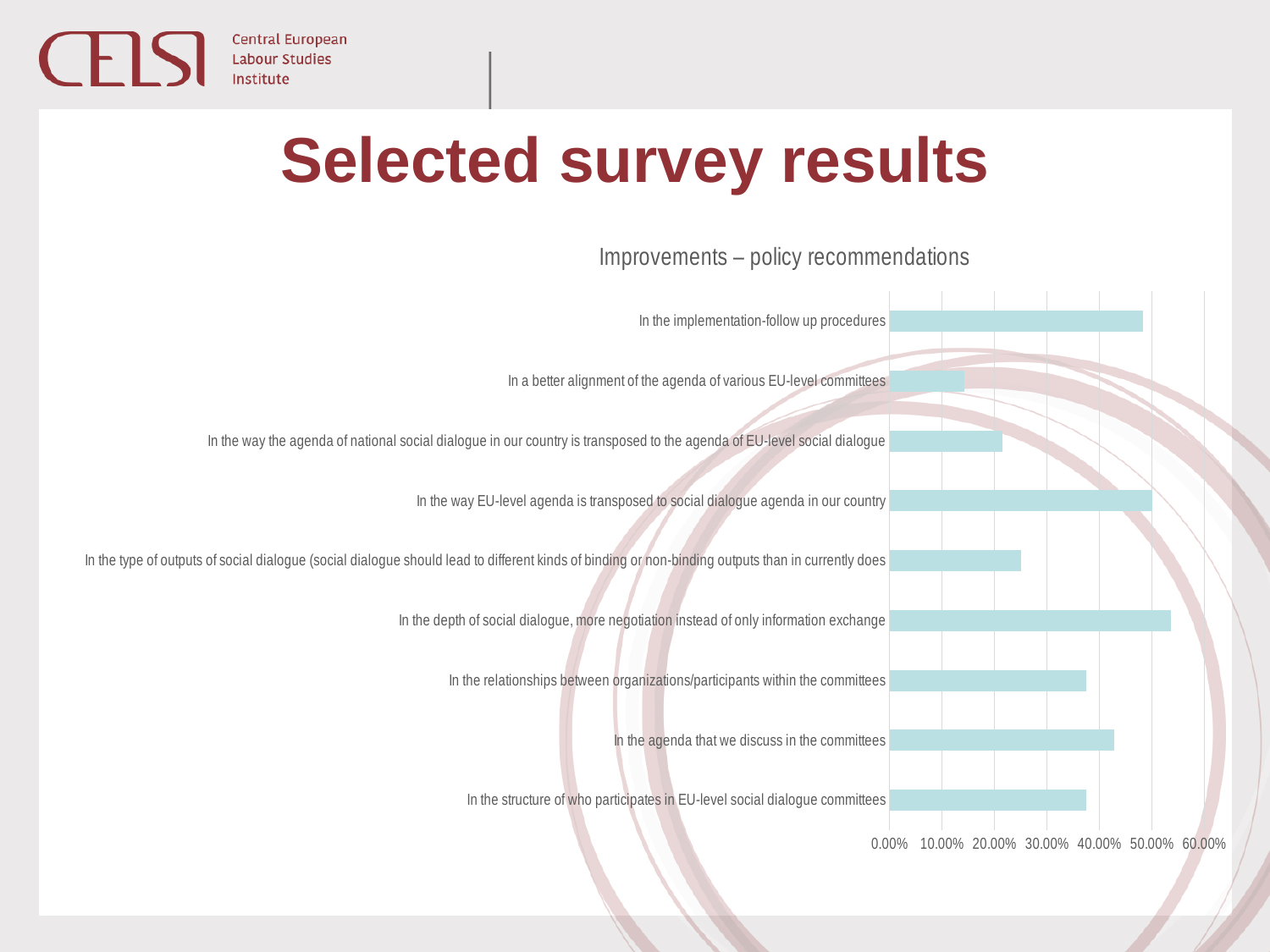
Which category has the highest value? In the depth of social dialogue, more negotiation instead of only information exchange Which category has the lowest value? In a better alignment of the agenda of various EU-level committees Is the value for "In the type of outputs of social dialogue" greater or less than 30.00%? less What kind of chart is shown on the slide? Bar chart Is the value for "In the depth of social dialogue, more negotiation instead of only information exchange" greater or less than 50.00%? greater Which is larger: the value for "In the agenda that we discuss in the committees" or for "In the relationships between organizations/participants within the committees"? In the agenda that we discuss in the committees What is the title of the chart? Improvements – policy recommendations How many categories are plotted in the chart? 9 Is the value for "In a better alignment of the agenda of various EU-level committees" greater or less than 20.00%? less Which is larger: the value for "In the implementation-follow up procedures" or for "In a better alignment of the agenda of various EU-level committees"? In the implementation-follow up procedures